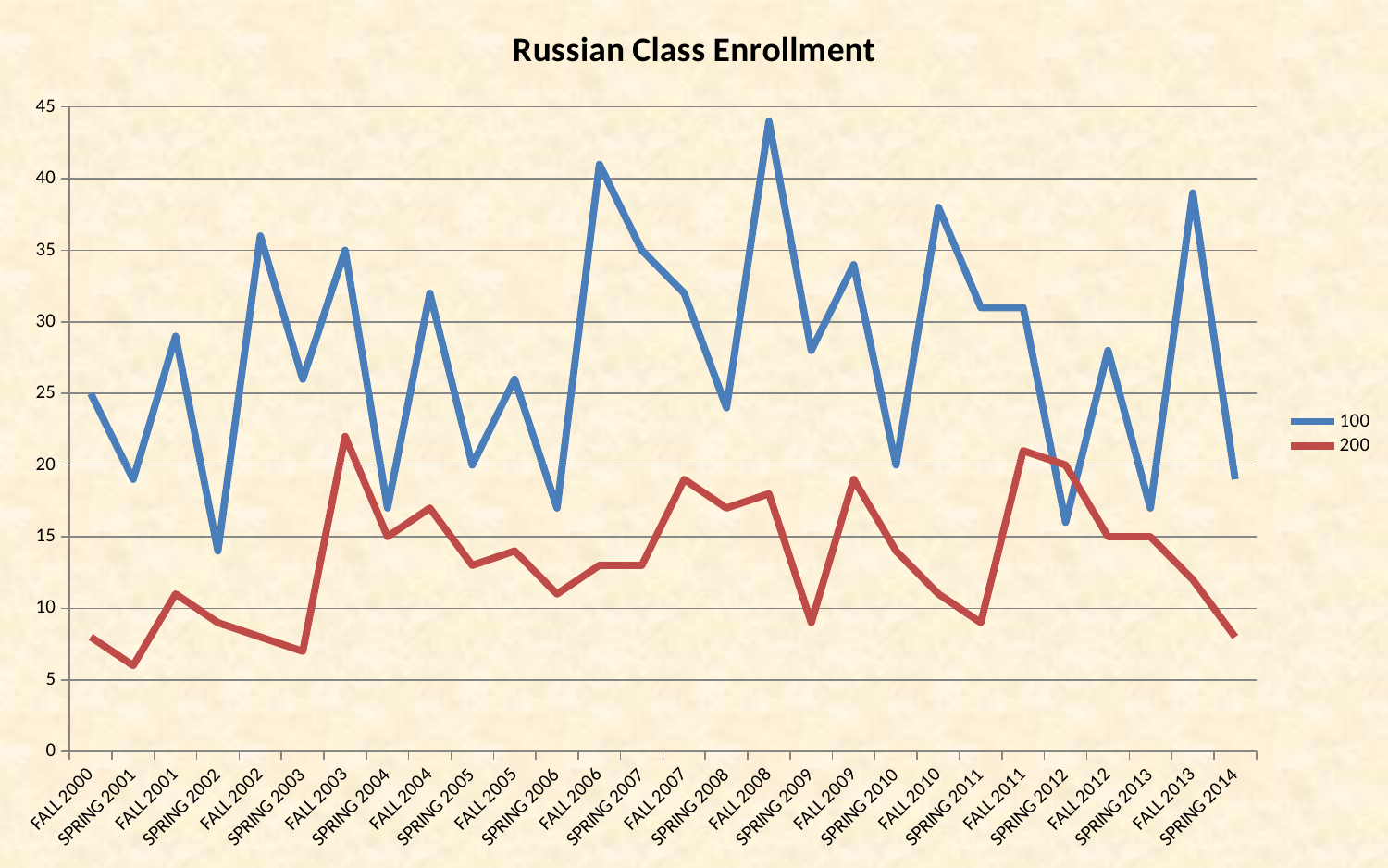
Is the value for the 200 series in FALL 2007 greater or less than 15? greater Does the 200 series rise or fall from FALL 2011 to SPRING 2014? fall How many semesters (categories) are shown on the x axis? 28 Is the value for the 100 series in FALL 2008 greater or less than 40? greater Which series has the larger value in FALL 2008, 100 or 200? 100 How many series does the legend list? 2 What is the title of the chart? Russian Class Enrollment In which semester does the 100 series reach its highest value? FALL 2008 Which line is drawn in red? 200 Is the value for the 200 series in FALL 2000 greater or less than 10? less In which semester does the 100 series reach its lowest value? SPRING 2002 What type of chart is shown on the slide? Line chart